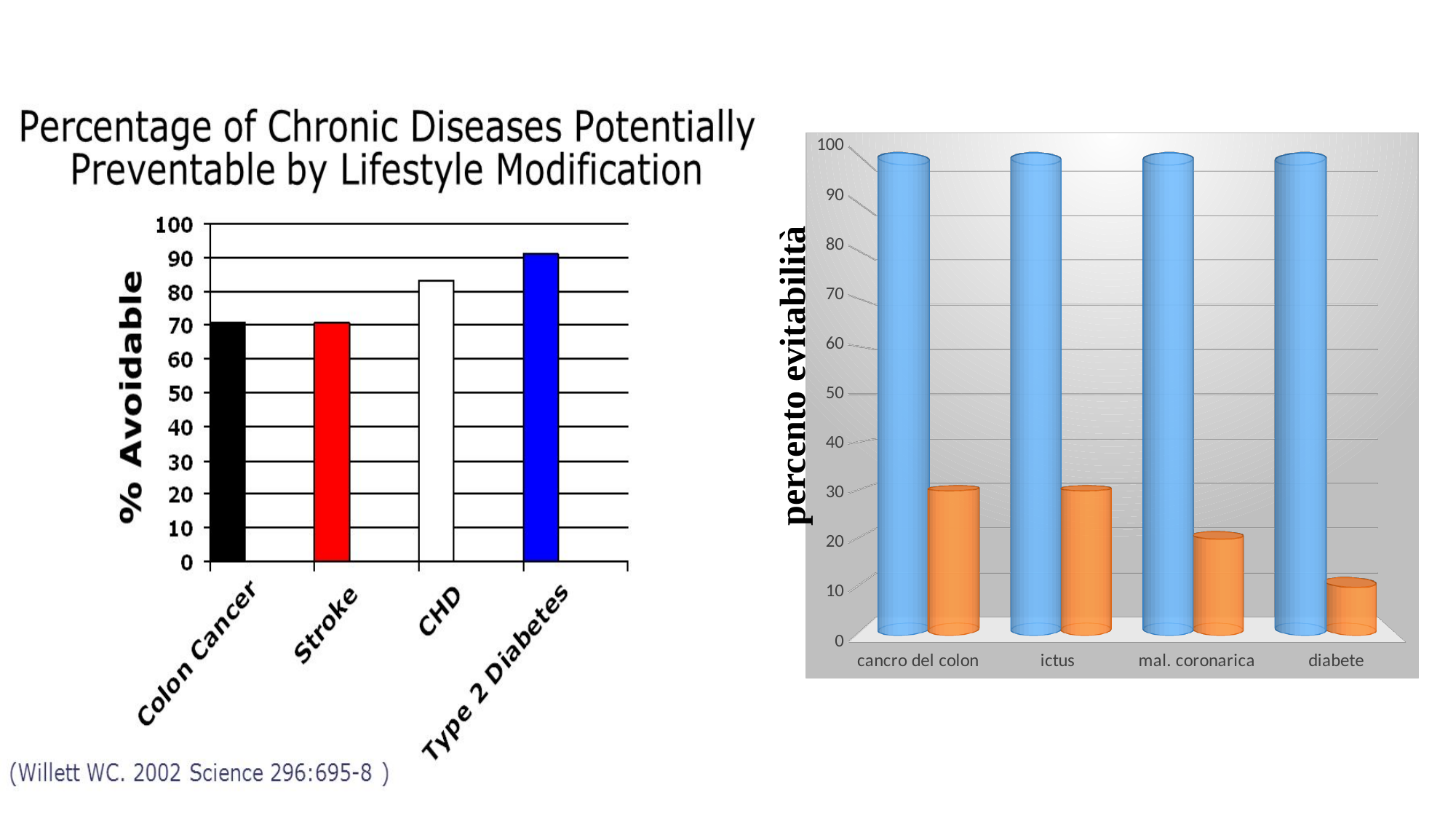
In the left chart, which disease has the highest percentage avoidable? Type 2 Diabetes In the left chart, how many disease categories are shown on the x axis? 4 What type of chart is the left chart titled 'Percentage of Chronic Diseases Potentially Preventable by Lifestyle Modification'? bar chart In the right chart, is the orange bar for mal. coronarica greater or less than 30? less In the left chart, is the value for CHD greater or less than 80? greater In the right chart, which category has the lowest orange bar? diabete In the left chart, which is larger, the value for CHD or the value for Stroke? CHD In the left chart, what is the label of the y axis? % Avoidable In the right chart, how many categories are shown on the x axis? 4 In the left chart, what colour is the bar for Stroke? red In the right chart, is the orange bar for diabete greater or less than 20? less